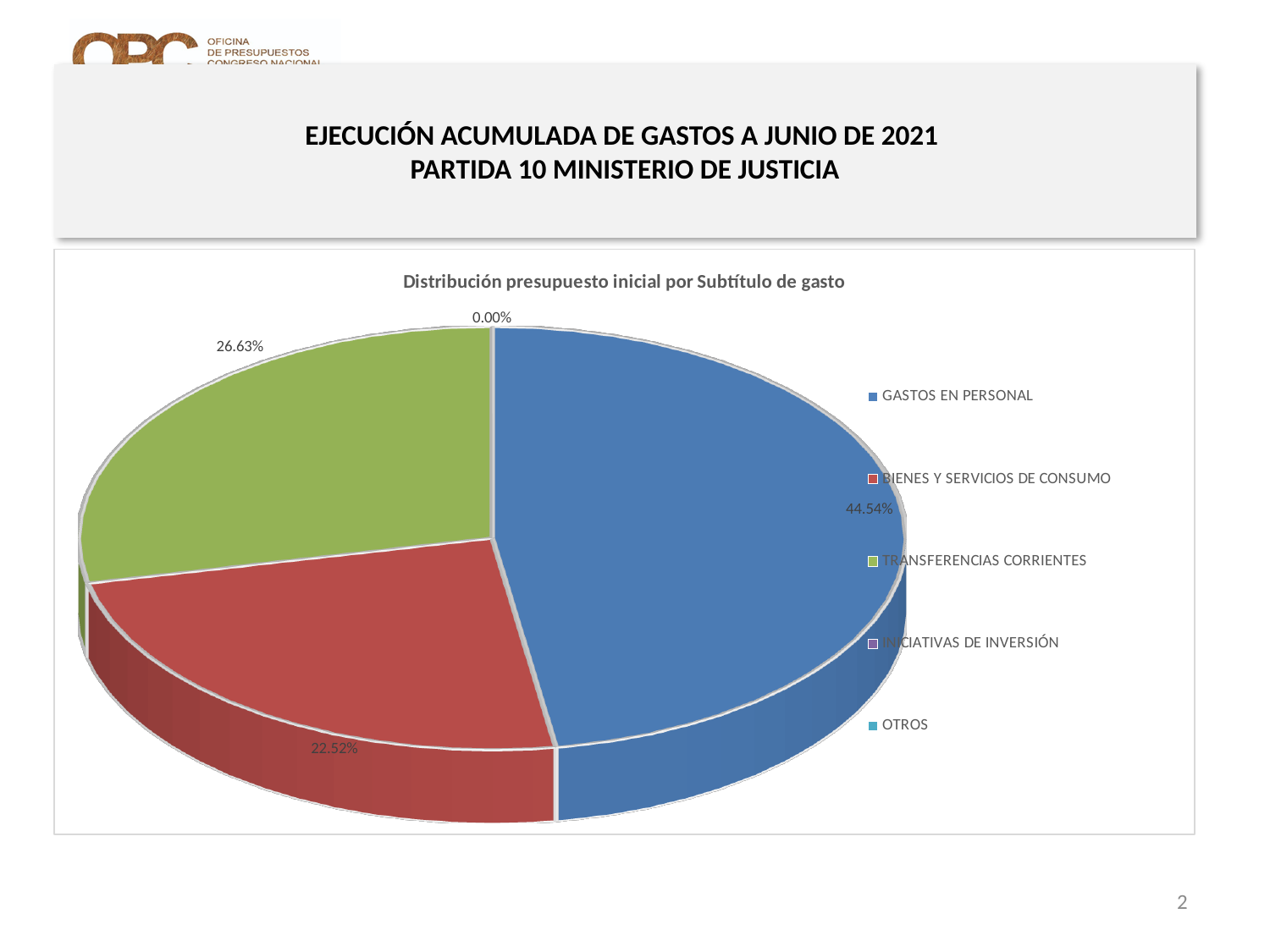
What colour is the slice for GASTOS EN PERSONAL? Blue What share of the pie does TRANSFERENCIAS CORRIENTES represent? 26.63% What is the difference in percentage points between the share for TRANSFERENCIAS CORRIENTES and the share for BIENES Y SERVICIOS DE CONSUMO? 4.11 How many entries does the chart legend list? 5 What share of the pie does BIENES Y SERVICIOS DE CONSUMO represent? 22.52% Is the share for GASTOS EN PERSONAL greater or less than 40%? greater What is the title of the chart? Distribución presupuesto inicial por Subtítulo de gasto Which is larger, the share for TRANSFERENCIAS CORRIENTES or the share for BIENES Y SERVICIOS DE CONSUMO? TRANSFERENCIAS CORRIENTES What share of the pie does GASTOS EN PERSONAL represent? 44.54% What type of chart is shown on the slide? Pie chart What is the difference in percentage points between the share for GASTOS EN PERSONAL and the share for BIENES Y SERVICIOS DE CONSUMO? 22.02 Which category has the largest share of the pie? GASTOS EN PERSONAL